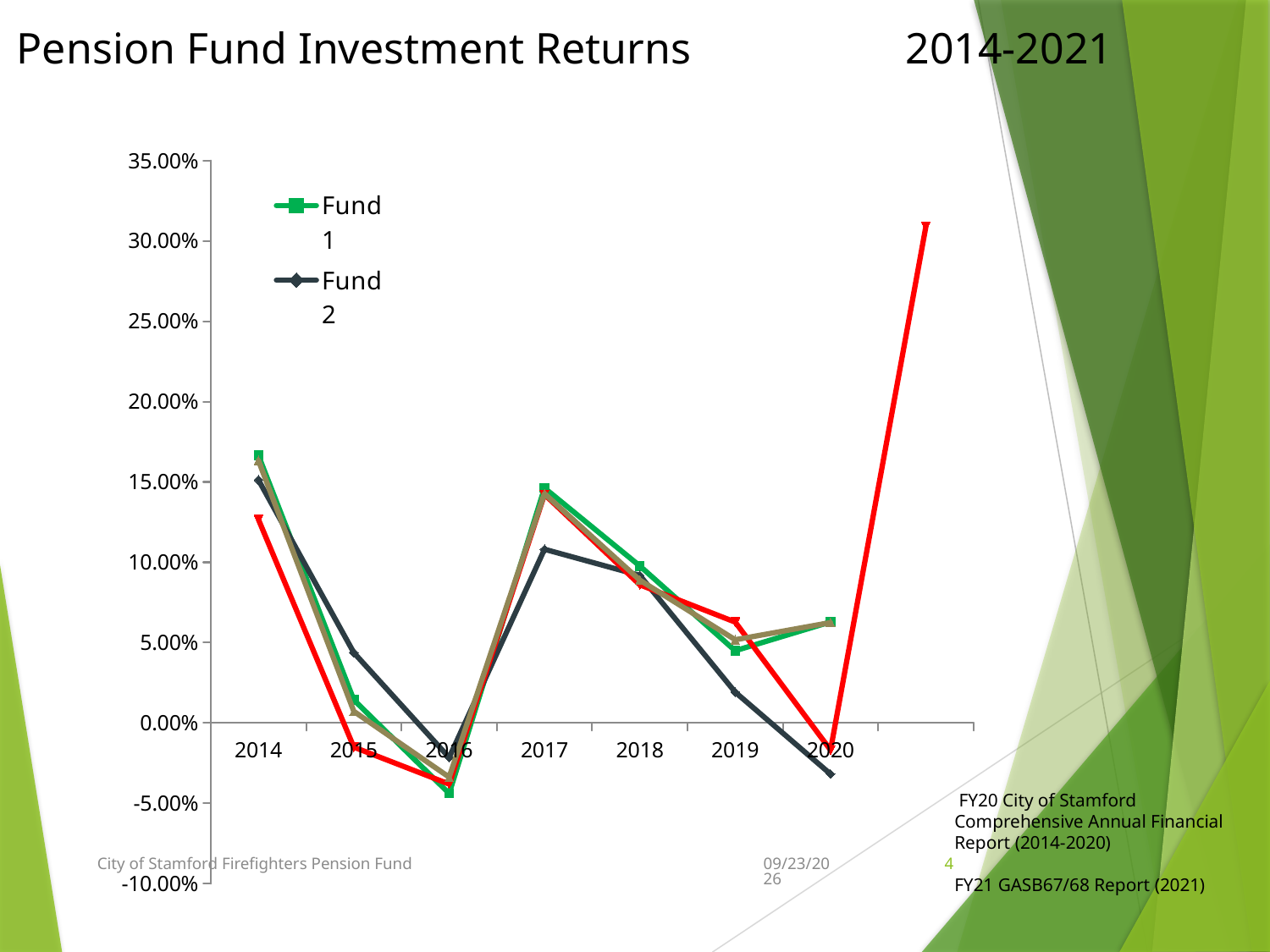
Is the value for Fund 1 in 2014 greater or less than 15.00%? greater In which year does Fund 1 reach its highest value? 2014 Does Fund 2 rise or fall from 2017 to 2020? fall How many years are labeled on the x axis? 7 Is the value for Fund 1 in 2016 greater or less than 0.00%? less What kind of chart is shown on the slide? line chart Is the value for Fund 2 in 2020 greater or less than 0.00%? less In 2015, which is larger, Fund 1 or Fund 2? Fund 2 How many series does the chart's legend list? 2 In which year does Fund 1 reach its lowest value? 2016 What is the title of the chart? Pension Fund Investment Returns 2014-2021